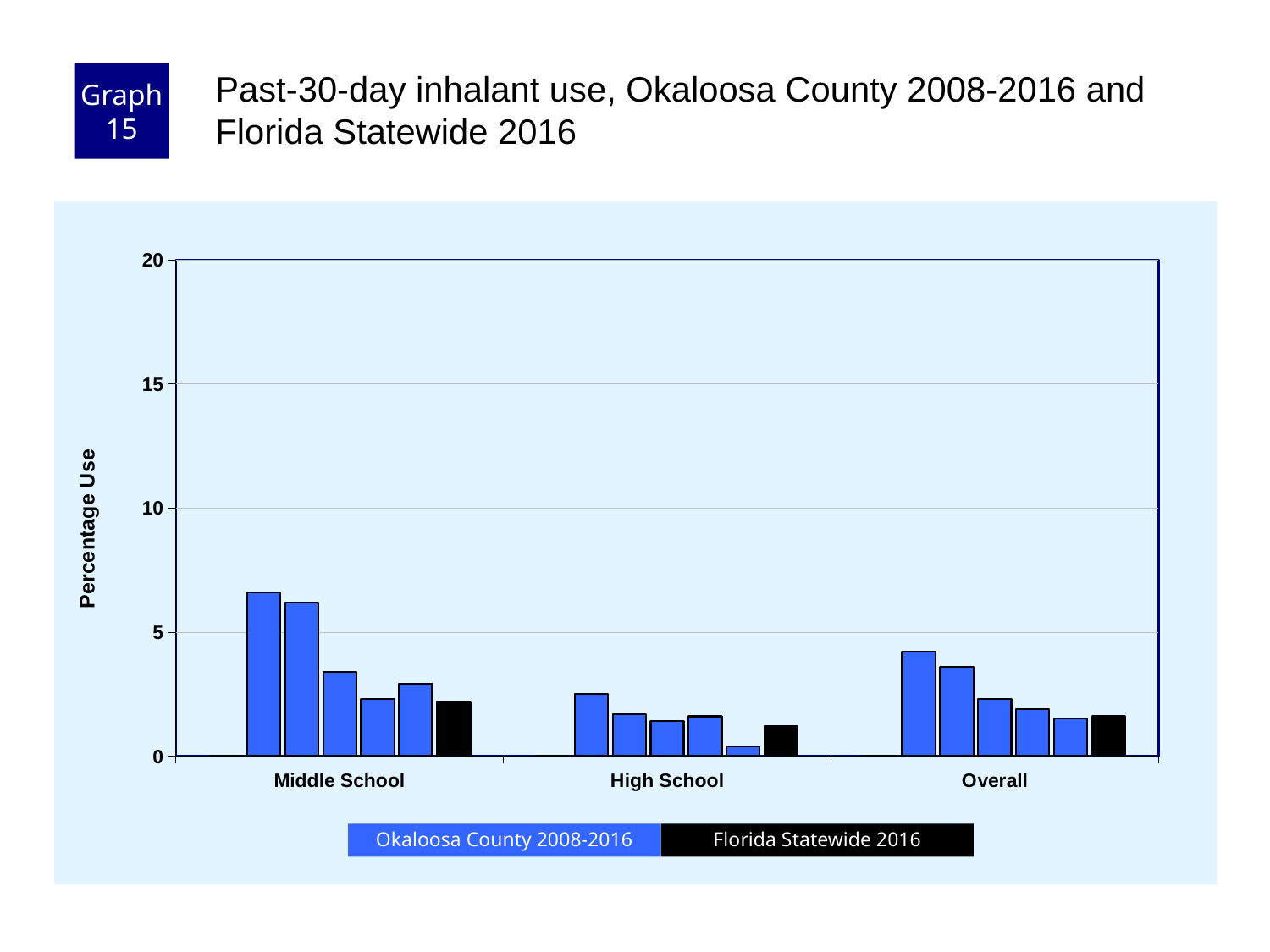
What is the label on the vertical axis? Percentage Use Is the value for the tallest Middle School bar greater or less than 5? greater Is any bar on the chart greater than 10? No How many series does the legend list? 2 Which category group contains the shortest bar on the chart? High School Is the value for the tallest Overall bar greater or less than 5? less Is the Florida Statewide 2016 bar larger for Middle School or for High School? Middle School Which series is shown in black in the legend? Florida Statewide 2016 What kind of chart is shown on the slide? bar chart How many school-level categories are shown on the x axis? 3 Which category group has the tallest bar overall? Middle School